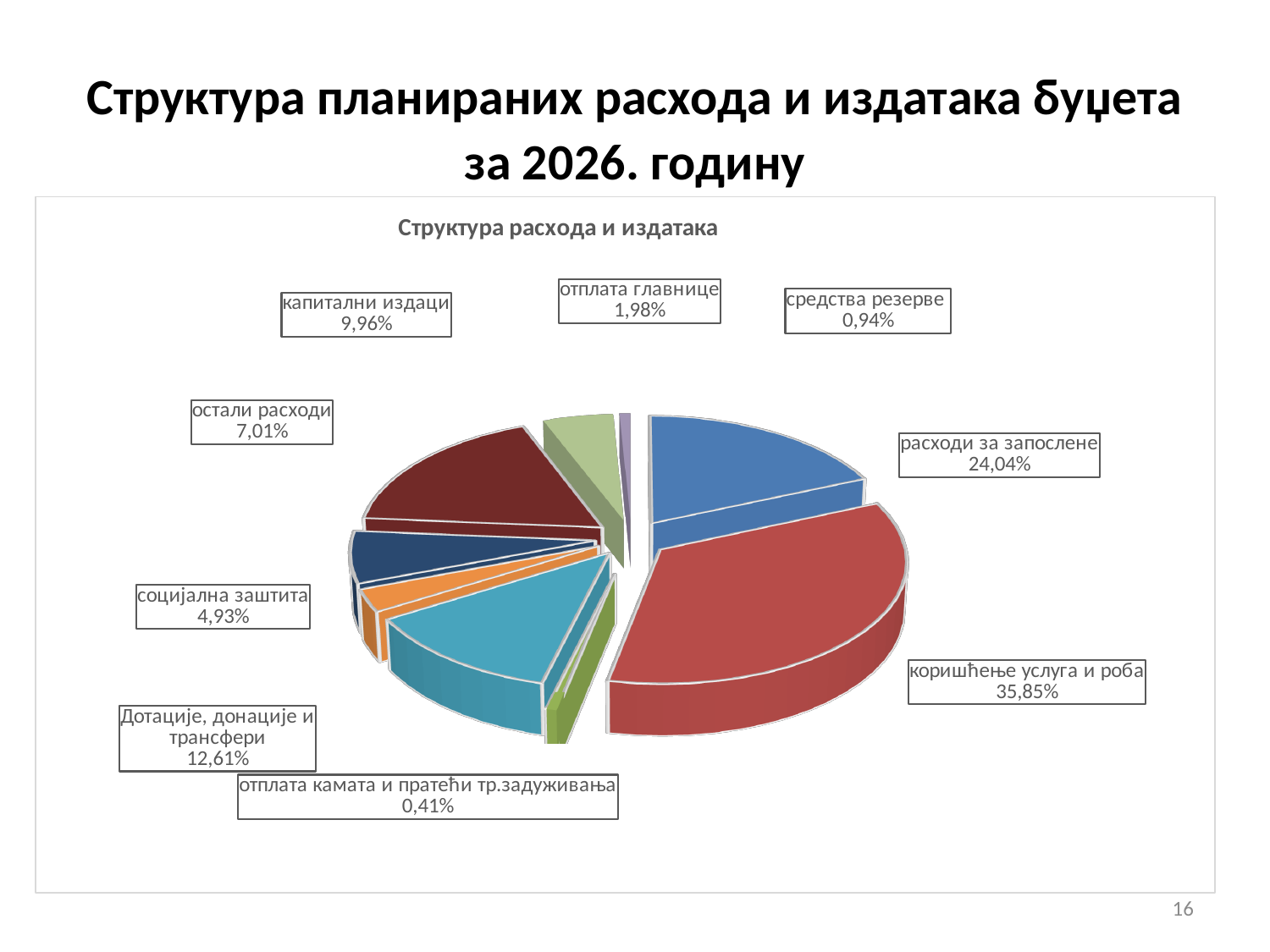
What percentage is shown for расходи за запослене? 24,04% What percentage is shown for средства резерве? 0,94% How many slices does the pie chart have? 9 What share of the pie is labelled for коришћење услуга и роба? 35,85% What percentage is shown for Дотације, донације и трансфери? 12,61% What is the difference in percentage points between коришћење услуга и роба and расходи за запослене? 11,81 Which category has the smallest share of the pie? отплата камата и пратећи тр.задуживања What is the title of the chart? Структура расхода и издатака Which is larger, the share for остали расходи or the share for социјална заштита? остали расходи What percentage is shown for капитални издаци? 9,96% Which category has the largest share of the pie? коришћење услуга и роба What kind of chart is shown on the slide? pie chart